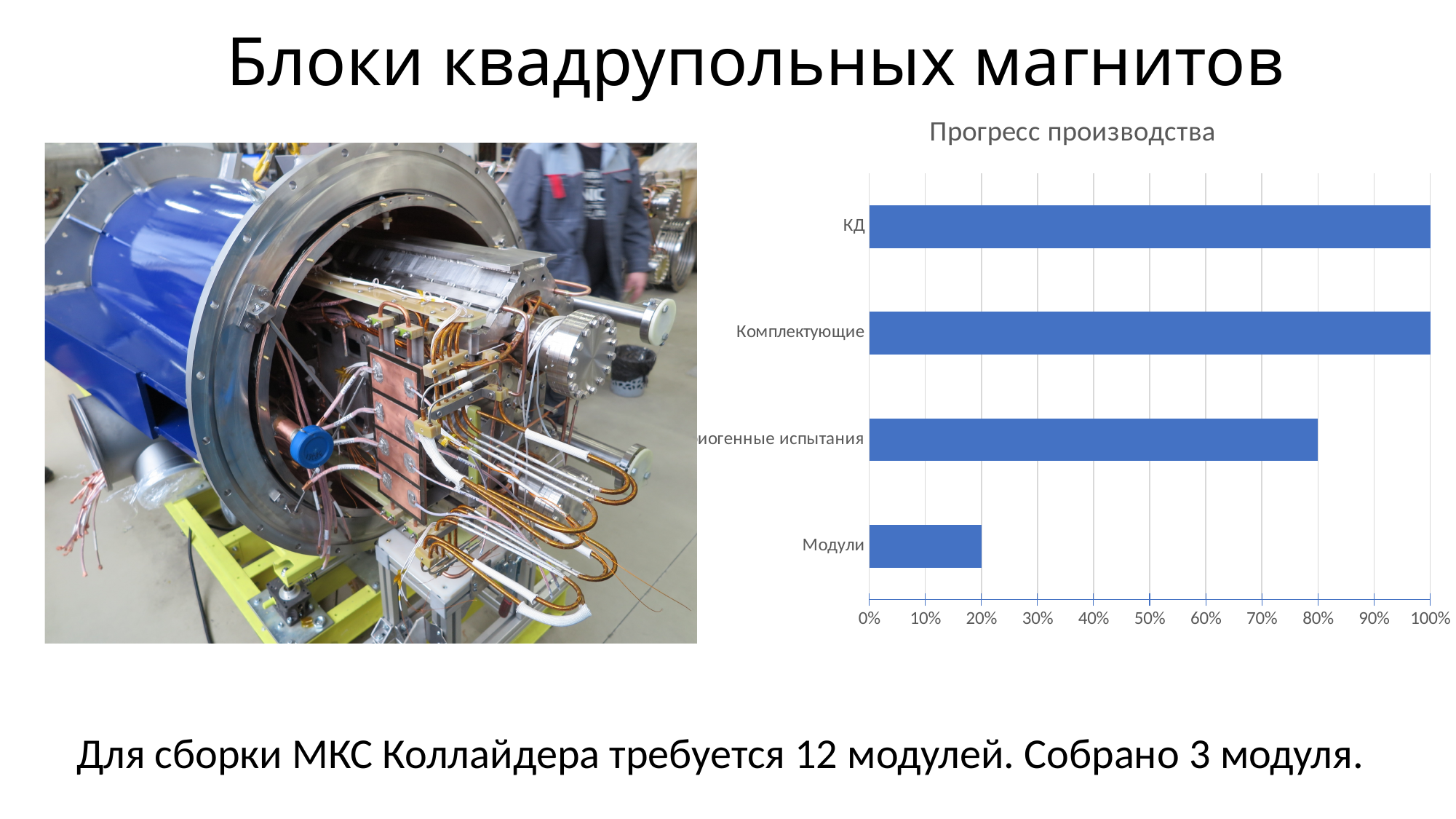
Is the value for "Модули" greater or less than 50%? less Which is larger in the "Прогресс производства" chart: the value for "КД" or the value for "Модули"? КД How many categories are shown in the "Прогресс производства" chart? 4 What is the value of the third bar from the top in the "Прогресс производства" chart? 80% What is the value for "КД" in the "Прогресс производства" chart? 100% Is the value of the third bar from the top greater or less than 50%? greater What is the title of the chart on the slide? Прогресс производства Which category has the lowest value in the "Прогресс производства" chart? Модули What is the value for "Модули" in the "Прогресс производства" chart? 20% What type of chart is shown under the title "Прогресс производства"? bar chart What is the difference between the value for "КД" and the value for "Модули"? 80% What is the value for "Комплектующие" in the "Прогресс производства" chart? 100%